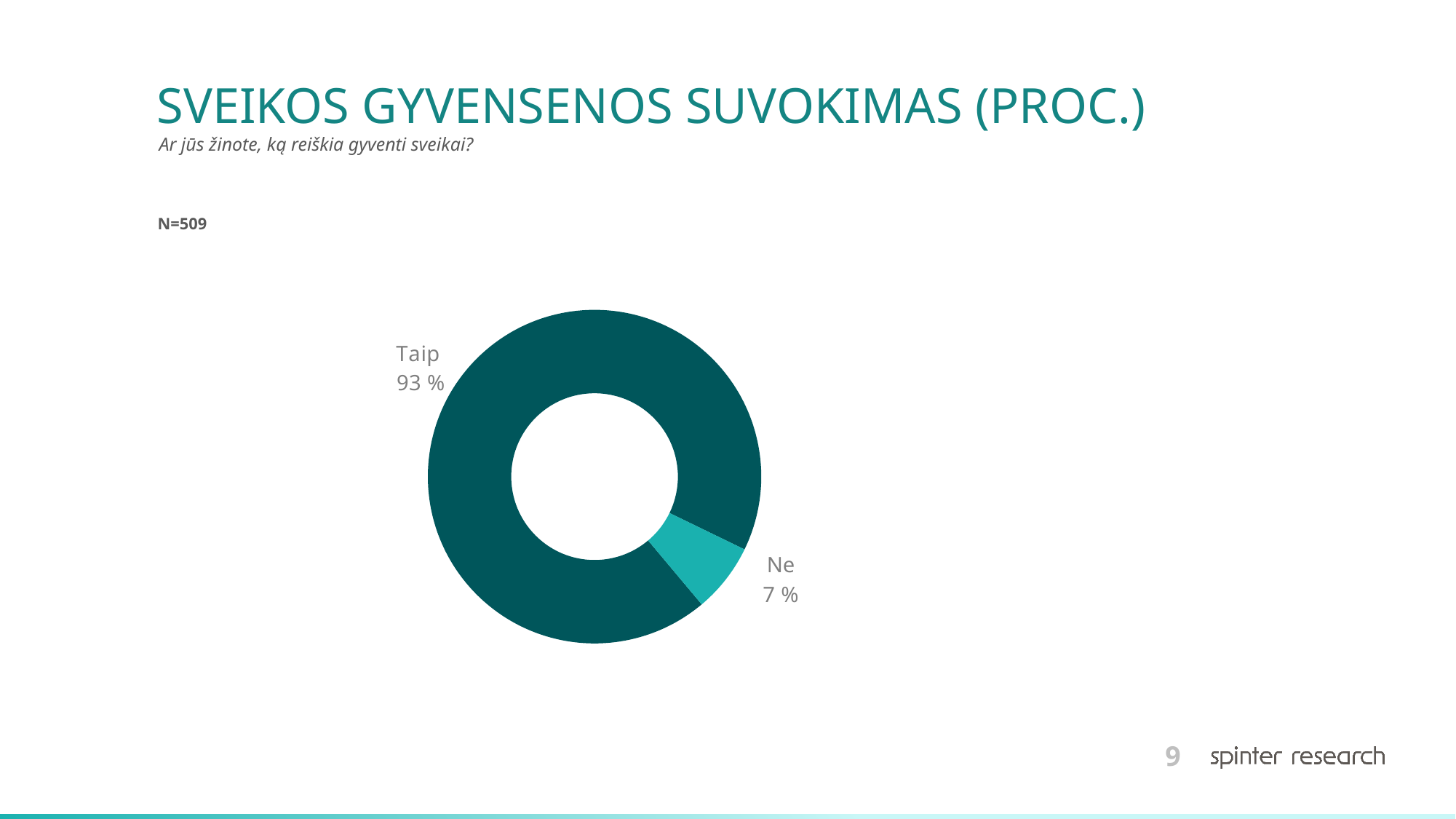
What percentage of respondents answered "Ne"? 7 % What percentage of respondents answered "Taip"? 93 % What kind of chart is shown on the slide? Doughnut (pie) chart Which category has the largest share of the chart? Taip What share of the chart does the "Ne" slice represent? 7 % How many categories are shown in the chart? 2 What is the sample size (N) stated on the slide? N=509 Which is larger, the share for "Taip" or the share for "Ne"? Taip Which category has the smallest share of the chart? Ne What is the difference in percentage points between "Taip" and "Ne"? 86 What is the title of the slide containing the chart? SVEIKOS GYVENSENOS SUVOKIMAS (PROC.)